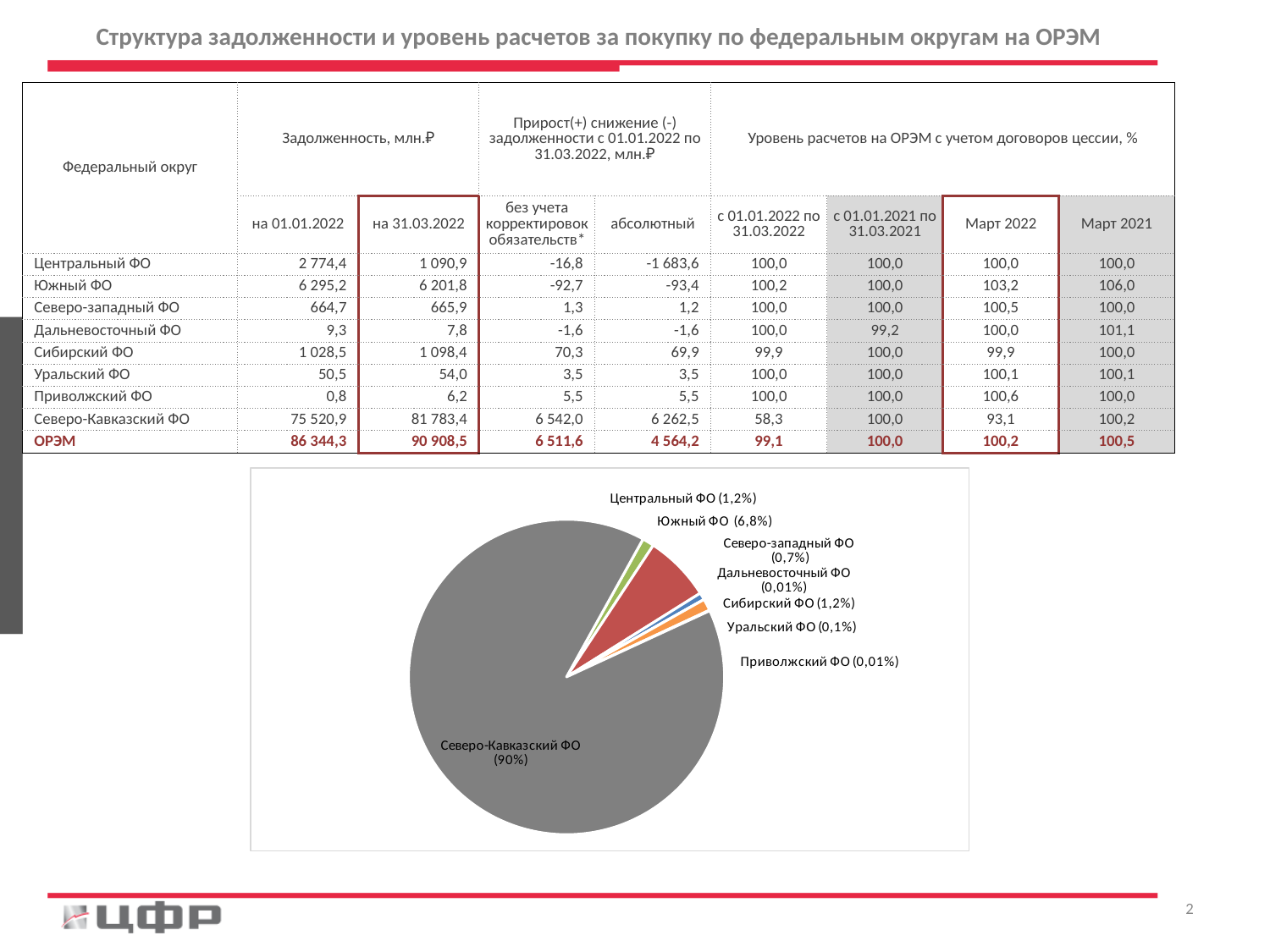
What share of the pie does Центральный ФО hold? 1,2% By how many percentage points does the share of Северо-Кавказский ФО exceed the share of Южный ФО in the pie chart? 83,2 What kind of chart is shown on the slide? pie chart Which slice is larger in the pie chart, Южный ФО or Центральный ФО? Южный ФО What share of the pie does Южный ФО hold? 6,8% What share of the pie does Северо-Кавказский ФО hold? 90% Which federal district has the largest slice in the pie chart? Северо-Кавказский ФО How many slices does the pie chart have? 8 Which two federal districts in the pie chart are labelled with a share of 0,01%? Дальневосточный ФО and Приволжский ФО